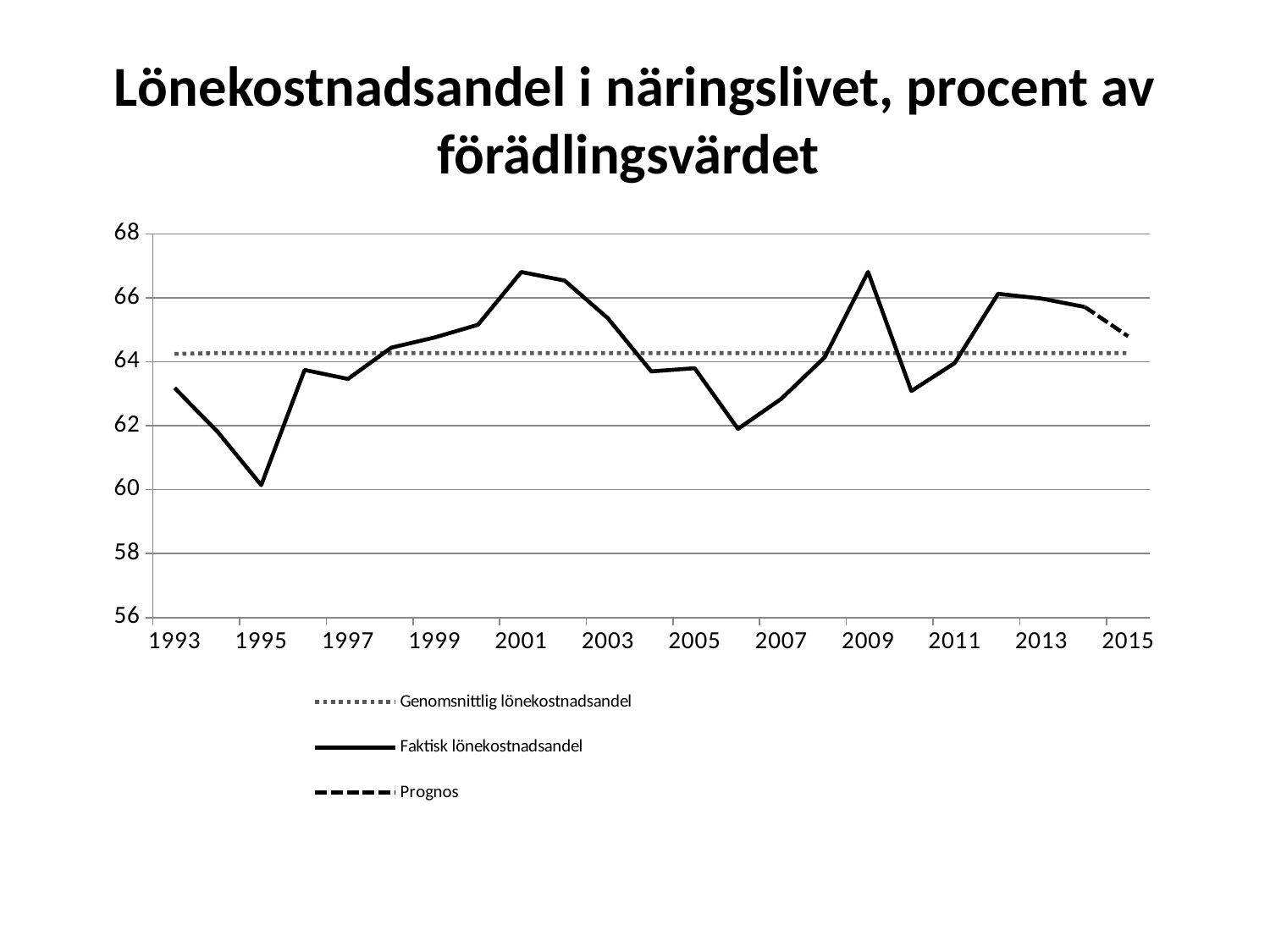
Is the value of Faktisk lönekostnadsandel in 2001 greater or less than 66? greater Which is larger, the Faktisk lönekostnadsandel in 1993 or in 1995? 1993 In which year is the Faktisk lönekostnadsandel at its lowest? 1995 Is the Prognos value for 2015 greater or less than 64? greater What kind of chart is shown on the slide? line chart How many series does the legend list? 3 What is the title of the chart? Lönekostnadsandel i näringslivet, procent av förädlingsvärdet Is the value of Faktisk lönekostnadsandel in 2010 greater or less than 64? less Which series is drawn with a dashed line according to the legend? Prognos Does the Faktisk lönekostnadsandel rise or fall between 1993 and 1995? fall Which is larger, the Faktisk lönekostnadsandel in 2009 or in 2010? 2009